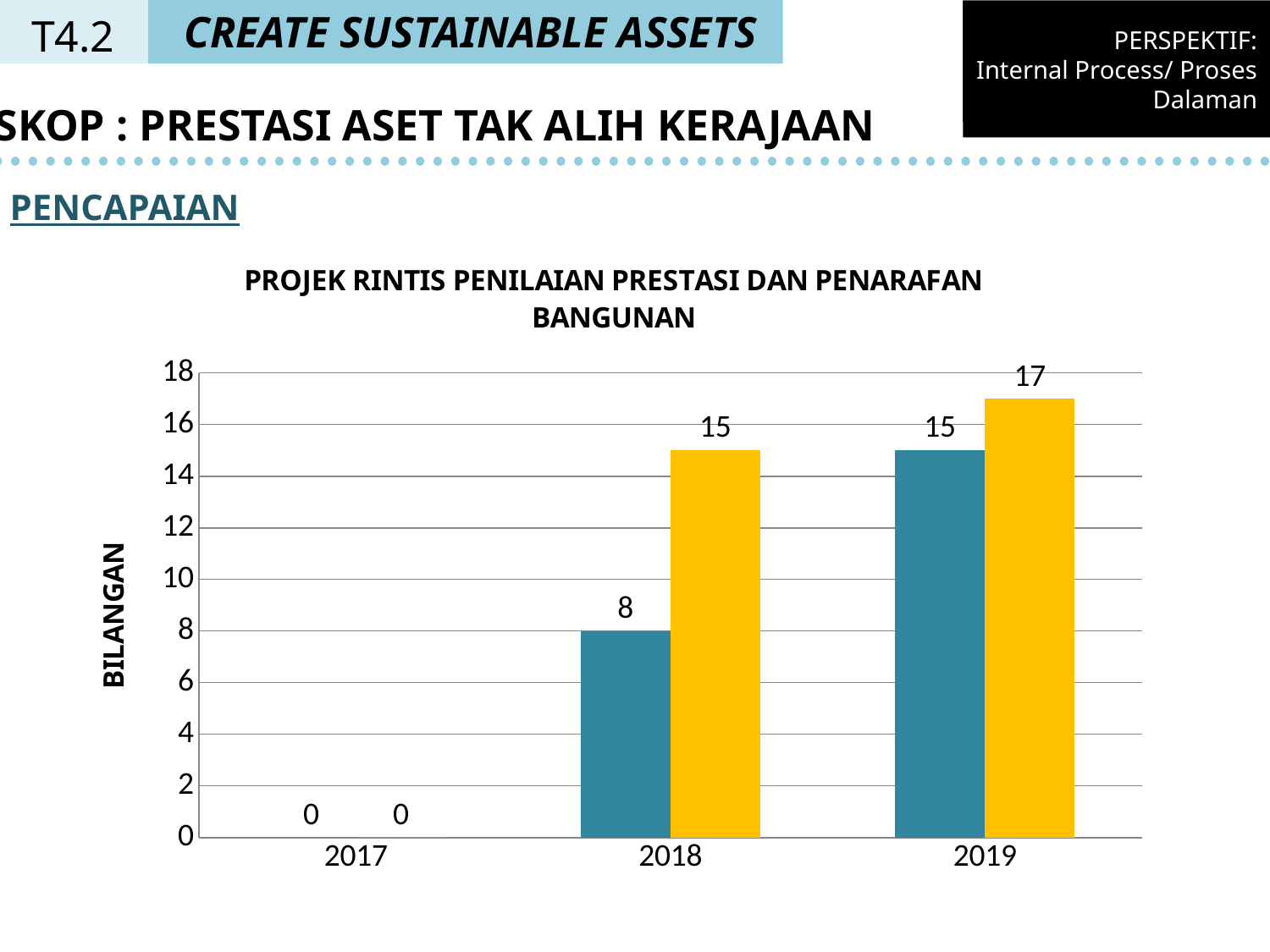
What is the value of the teal bar for 2019? 15 What is the value of the yellow bar for 2018? 15 How many years are shown on the x axis? 3 In 2019, which bar is larger, the teal bar or the yellow bar? the yellow bar What is the value of the teal bar for 2018? 8 Do the yellow bar values rise or fall from 2017 to 2019? rise What kind of chart is shown on the slide? bar chart What is the label on the y axis of the chart? BILANGAN Which year has the highest yellow bar? 2019 What is the difference between the yellow bar and the teal bar in 2018? 7 What is the value of the yellow bar for 2019? 17 Which year has the lowest values for both bars? 2017